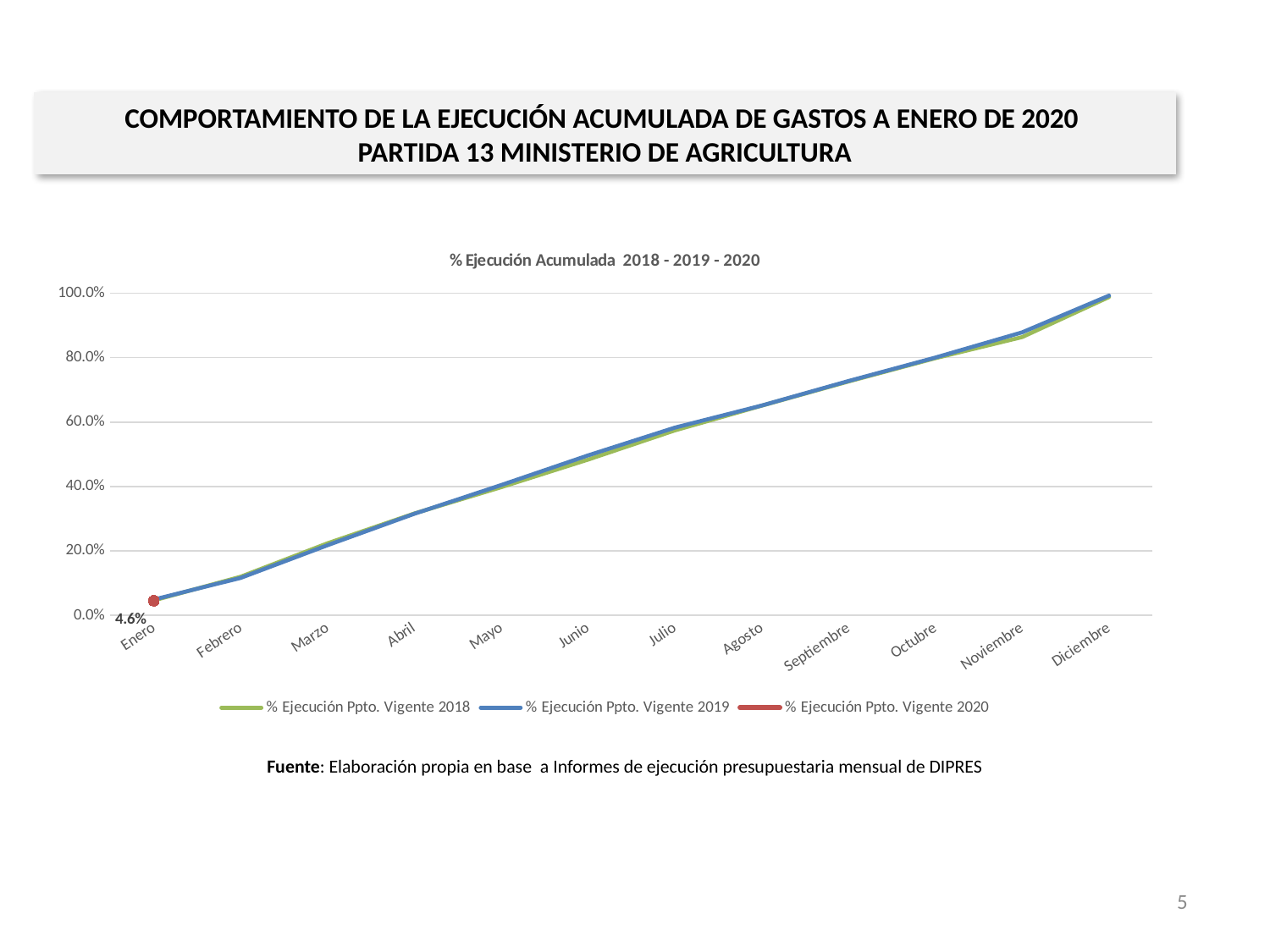
Do the values for % Ejecución Ppto. Vigente 2019 rise or fall from Enero to Diciembre? rise What kind of chart is shown on the slide? line chart How many months are shown along the x axis? 12 Which month has the lowest value for % Ejecución Ppto. Vigente 2018? Enero What is the title of the chart? % Ejecución Acumulada 2018 - 2019 - 2020 How many series does the legend list? 3 What is the value for % Ejecución Ppto. Vigente 2020 in Enero? 4.6% Is the value for % Ejecución Ppto. Vigente 2019 in Diciembre greater or less than 80.0%? greater Is the value for % Ejecución Ppto. Vigente 2018 in Septiembre greater or less than 60.0%? greater What colour is used for the % Ejecución Ppto. Vigente 2020 series? red Is the value for % Ejecución Ppto. Vigente 2019 in Junio greater or less than 60.0%? less Which month has the highest value for % Ejecución Ppto. Vigente 2019? Diciembre